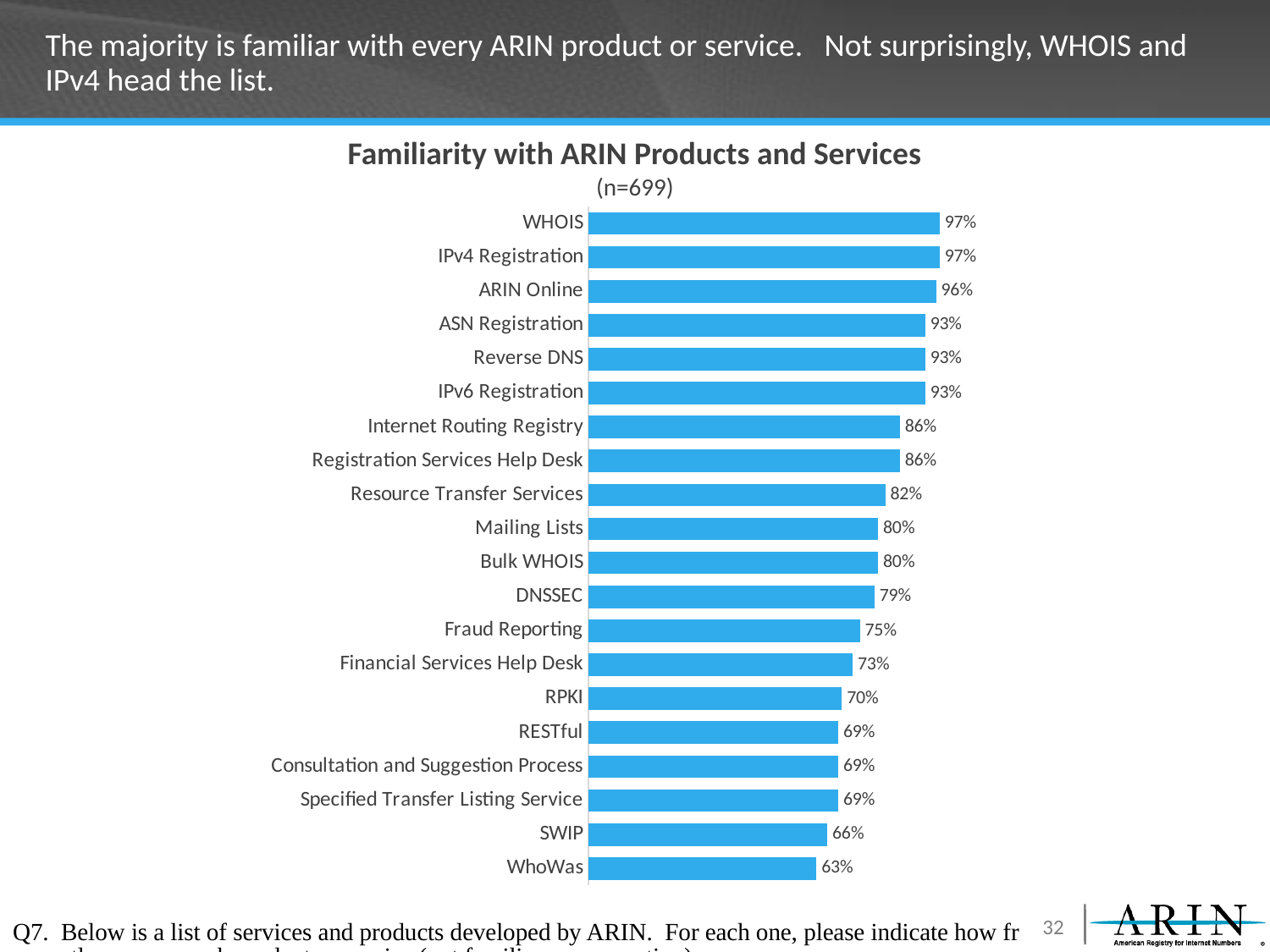
Which is larger, the value for Internet Routing Registry or the value for RESTful? Internet Routing Registry What is the difference between the values for WHOIS and WhoWas? 34% What is the value for RPKI? 70% What is the difference between the values for DNSSEC and Fraud Reporting? 4% What kind of chart is shown on the slide? Bar chart What is the value for SWIP? 66% Which category has the lowest value? WhoWas What is the value for Resource Transfer Services? 82% Which is larger, the value for Mailing Lists or the value for Financial Services Help Desk? Mailing Lists What is the sample size shown under the chart title? n=699 What is the value for ARIN Online? 96% How many categories are shown in the chart? 20